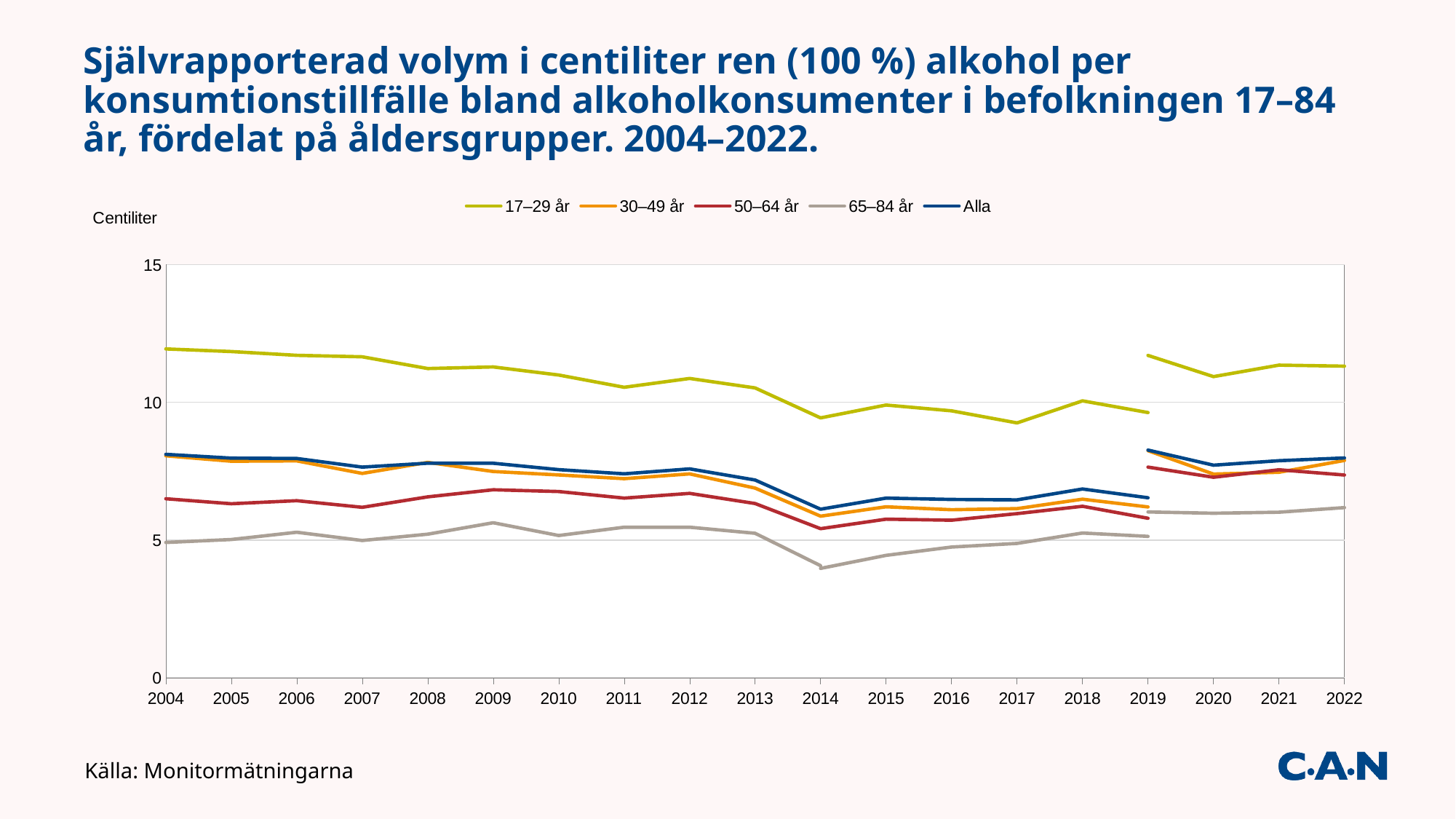
Which is larger in 2010, the value for 17–29 år or the value for 65–84 år? 17–29 år Does the 17–29 år series rise or fall from 2004 to 2014? fall Is the value for 65–84 år in 2014 greater or less than 5? less Is the value for 17–29 år in 2014 greater or less than 10? less What unit label is shown on the y axis? Centiliter How many years are plotted along the x axis? 19 Is the value for 17–29 år in 2004 greater or less than 10? greater How many series does the legend list? 5 In which year does the 65–84 år series reach its lowest value? 2014 Which age group has the highest values across the whole period? 17–29 år Which age group has the lowest values across the whole period? 65–84 år What kind of chart is shown on the slide? line chart